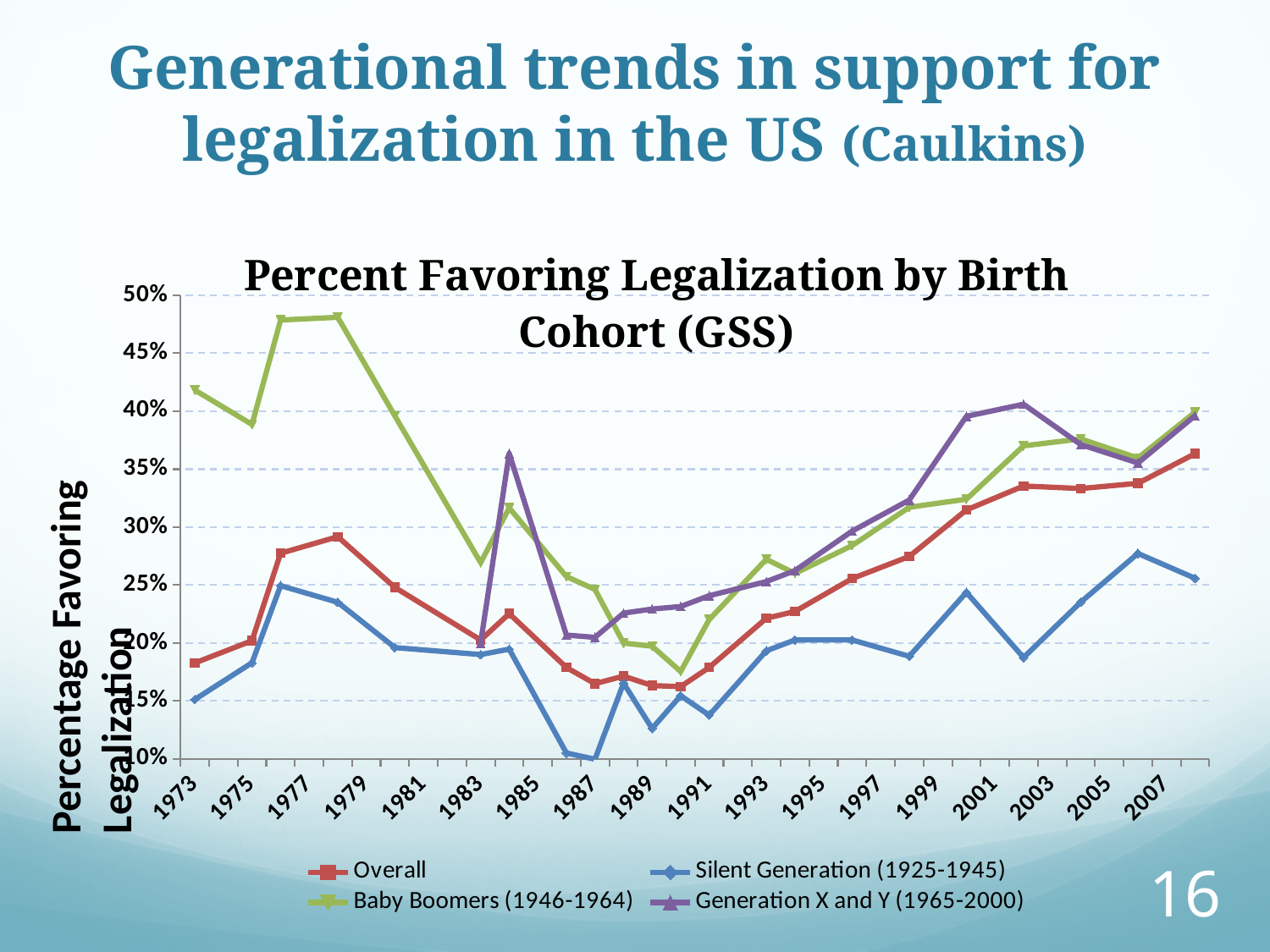
How many series does the legend list? 4 Is the value for Generation X and Y (1965-2000) in 2001 greater or less than 35%? greater Is the value for Baby Boomers (1946-1964) in 1977 greater or less than 45%? greater Is the value for Silent Generation (1925-1945) in 1987 greater or less than 15%? less What kind of chart is shown on the slide? Line chart Which birth years does the legend give for the Silent Generation series? 1925-1945 Which series has the lowest value in 1987? Silent Generation (1925-1945) Which series has the highest value in 1979? Baby Boomers (1946-1964) What is the title of the chart? Percent Favoring Legalization by Birth Cohort (GSS) Does the Baby Boomers (1946-1964) series rise or fall between 1979 and 1983? Fall In 1977, which is higher: Baby Boomers (1946-1964) or Overall? Baby Boomers (1946-1964)